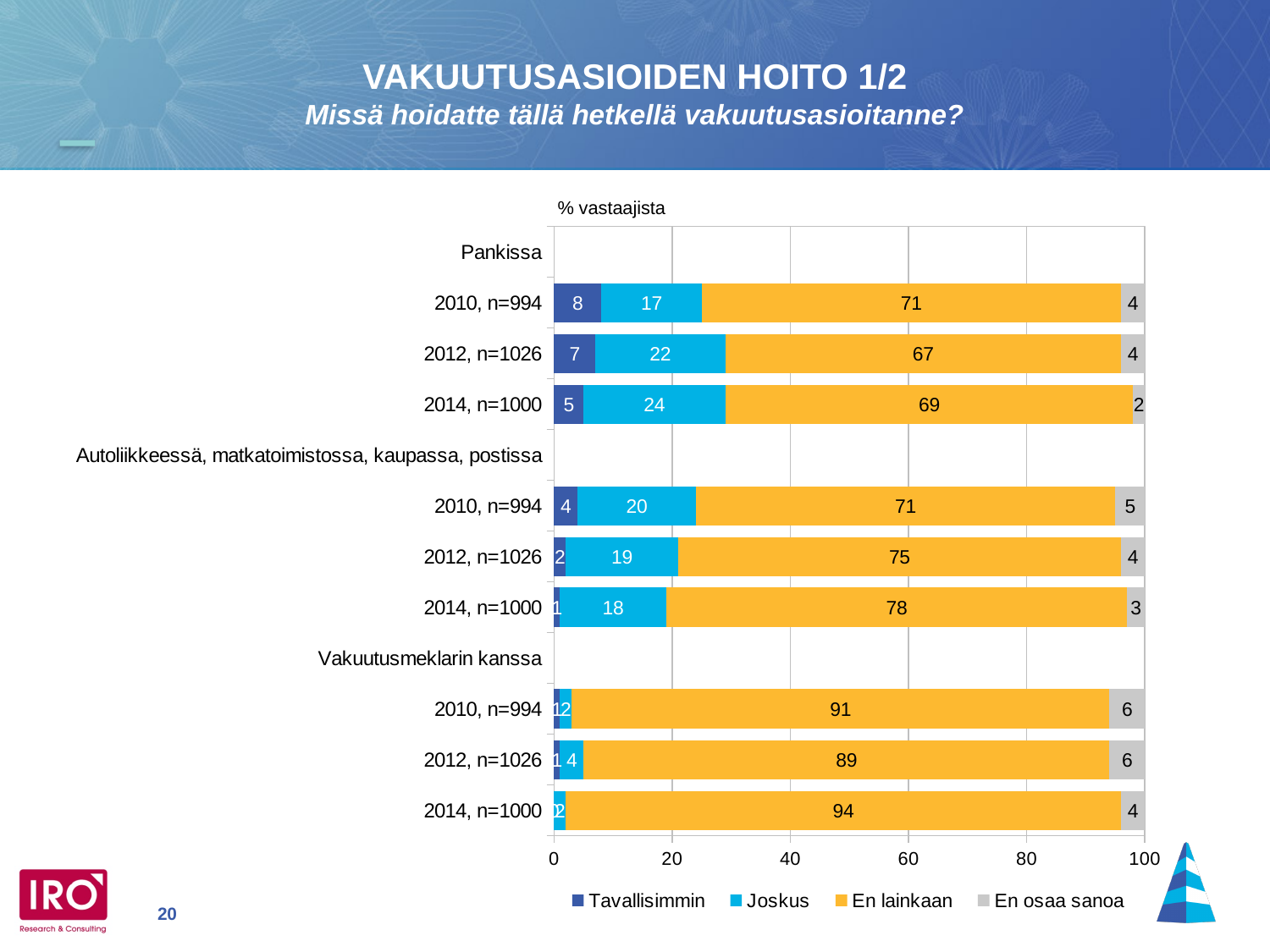
What kind of chart is shown on the slide? Stacked bar chart What is the total of the stacked bar for Pankissa in 2010, n=994? 100 What is the 'Tavallisimmin' value for Autoliikkeessä, matkatoimistossa, kaupassa, postissa in 2010, n=994? 4 What is the difference between the 'Joskus' values for Pankissa in 2014, n=1000 and 2010, n=994? 7 What is the 'En lainkaan' value for Pankissa in 2010, n=994? 71 Does the 'En lainkaan' value for Autoliikkeessä, matkatoimistossa, kaupassa, postissa rise or fall from 2010 to 2014? Rise How many series does the legend list? 4 Which row has the highest 'En lainkaan' value? Vakuutusmeklarin kanssa, 2014, n=1000 What is the 'En lainkaan' value for Vakuutusmeklarin kanssa in 2014, n=1000? 94 Which is larger: the 'En lainkaan' value for Autoliikkeessä in 2014, n=1000 or for Pankissa in 2014, n=1000? Autoliikkeessä in 2014, n=1000 Which row has the lowest 'En lainkaan' value? Pankissa, 2012, n=1026 What is the 'Joskus' value for Pankissa in 2014, n=1000? 24